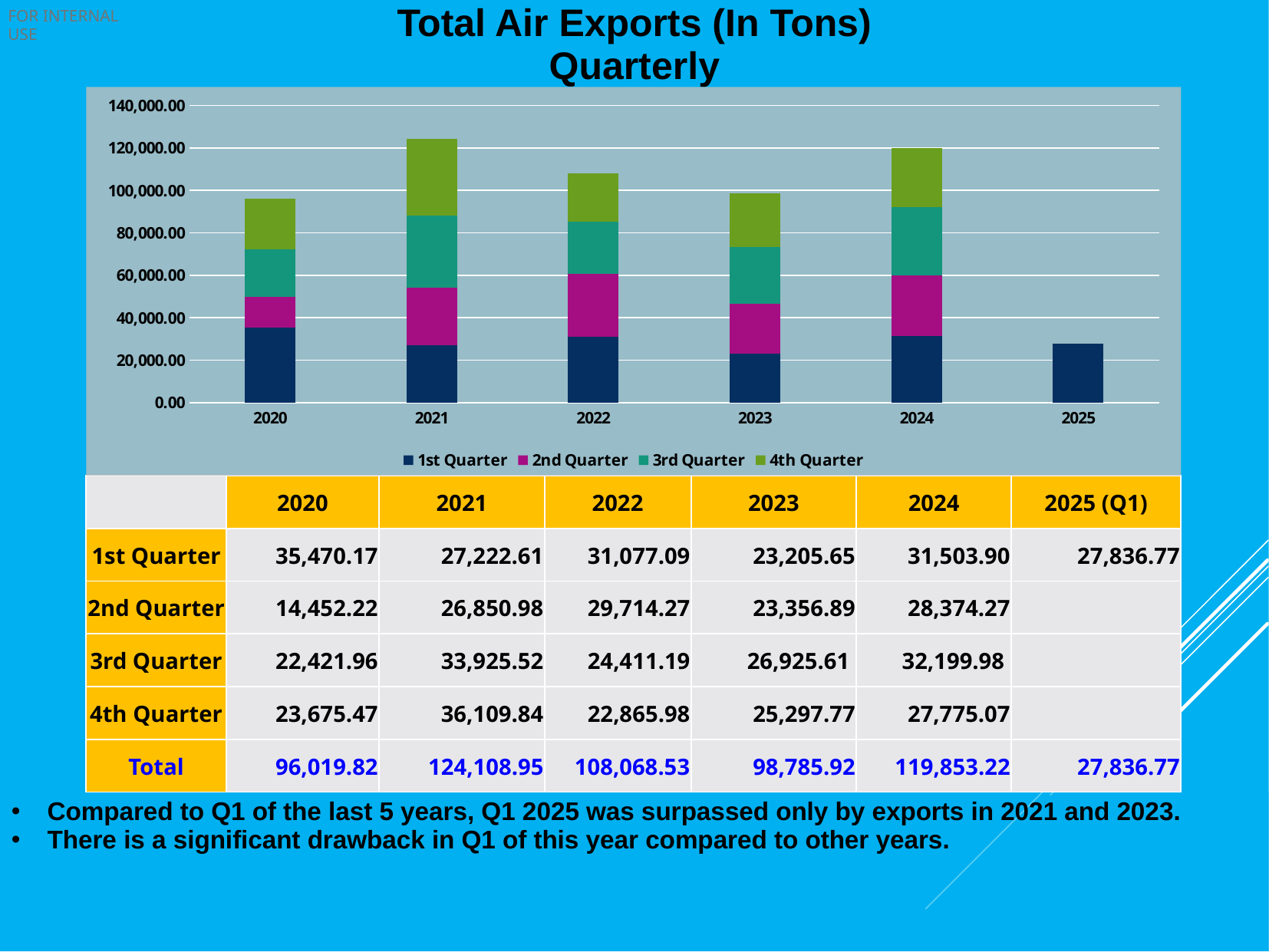
What is the 4th Quarter value for 2021? 36,109.84 Which year has the tallest stacked bar? 2021 What kind of chart is shown on the slide? Stacked bar chart Which year has the larger 3rd Quarter value, 2021 or 2022? 2021 Is the total for 2024 greater or less than 100,000.00? greater What is the 1st Quarter value for 2020? 35,470.17 Which year has the shortest stacked bar? 2025 How many years are shown along the x axis of the chart? 6 What is the title of the chart? Total Air Exports (In Tons) Quarterly What is the difference between the 1st Quarter values for 2020 and 2023? 12,264.52 How many series does the chart legend list? 4 What is the total of the stacked bar for 2021? 124,108.95